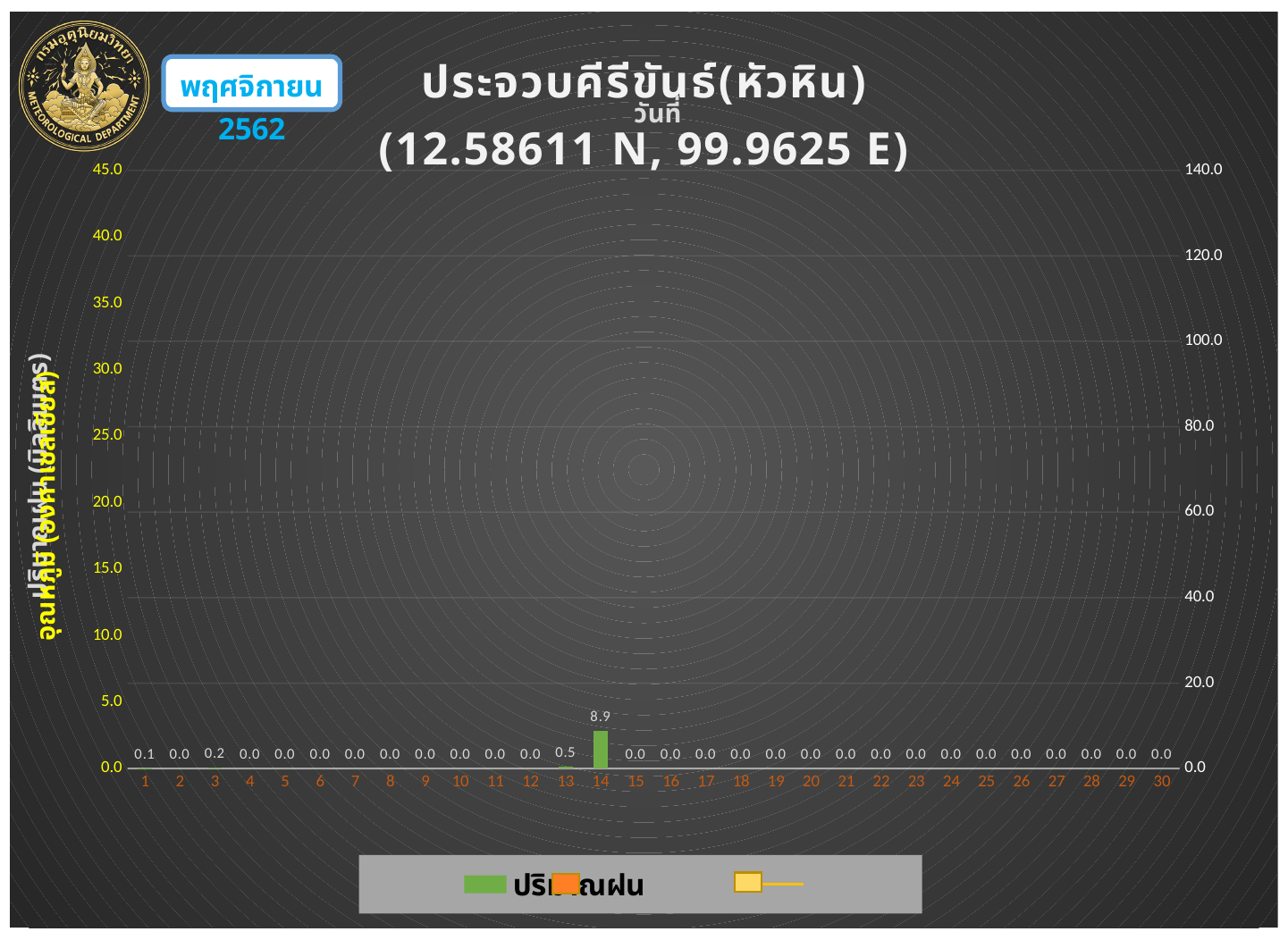
What is the value shown for day 13? 0.5 What kind of chart is shown on the slide? bar chart How many days (categories) are shown on the x axis? 30 What is the difference between the values for day 14 and day 13? 8.4 Which day has the highest value on the chart? 14 Is the value for day 14 greater or less than 5.0? greater What is the value shown for day 1? 0.1 What is the value shown for day 3? 0.2 What is the rainfall value shown for day 14? 8.9 What is the highest tick value on the left vertical axis? 45.0 What is the highest tick value on the right vertical axis? 140.0 Which is larger, the value for day 3 or the value for day 1? day 3